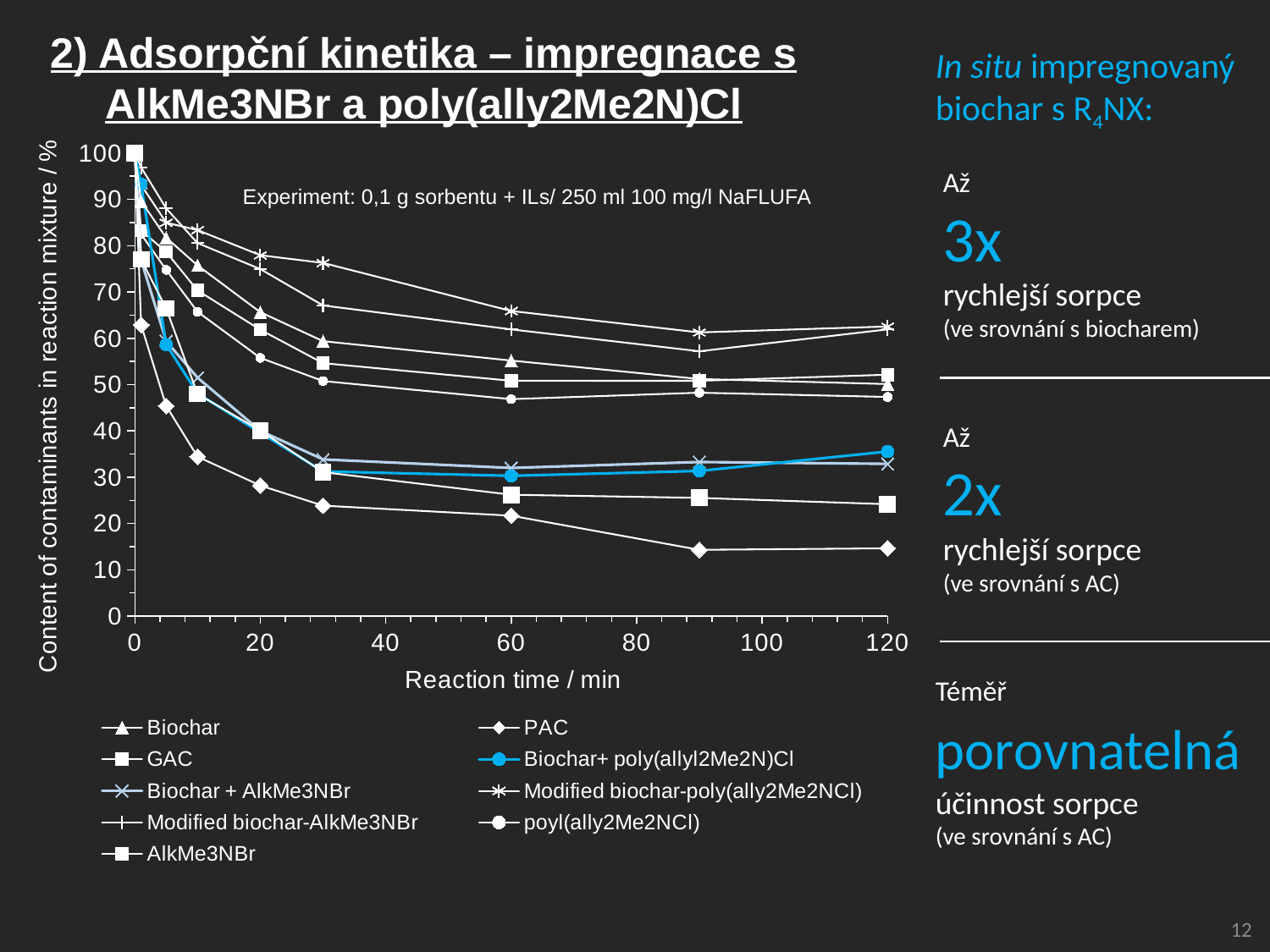
At 120 min, which series has the larger value, GAC or PAC? GAC Which series has the lowest value at 120 min? PAC How many series does the legend of the chart list? 9 What is the label of the x axis of the chart? Reaction time / min Is the value for Biochar at 120 min greater or less than 40? greater Do the values of the series rise or fall as reaction time increases? fall Is the value for AlkMe3NBr at 120 min greater or less than 30? greater Is the value for PAC at 120 min greater or less than 20? less What experiment description is printed inside the chart area? Experiment: 0,1 g sorbentu + ILs/ 250 ml 100 mg/l NaFLUFA What is the value of the series at 0 min? 100 What type of chart is shown on the slide? line chart